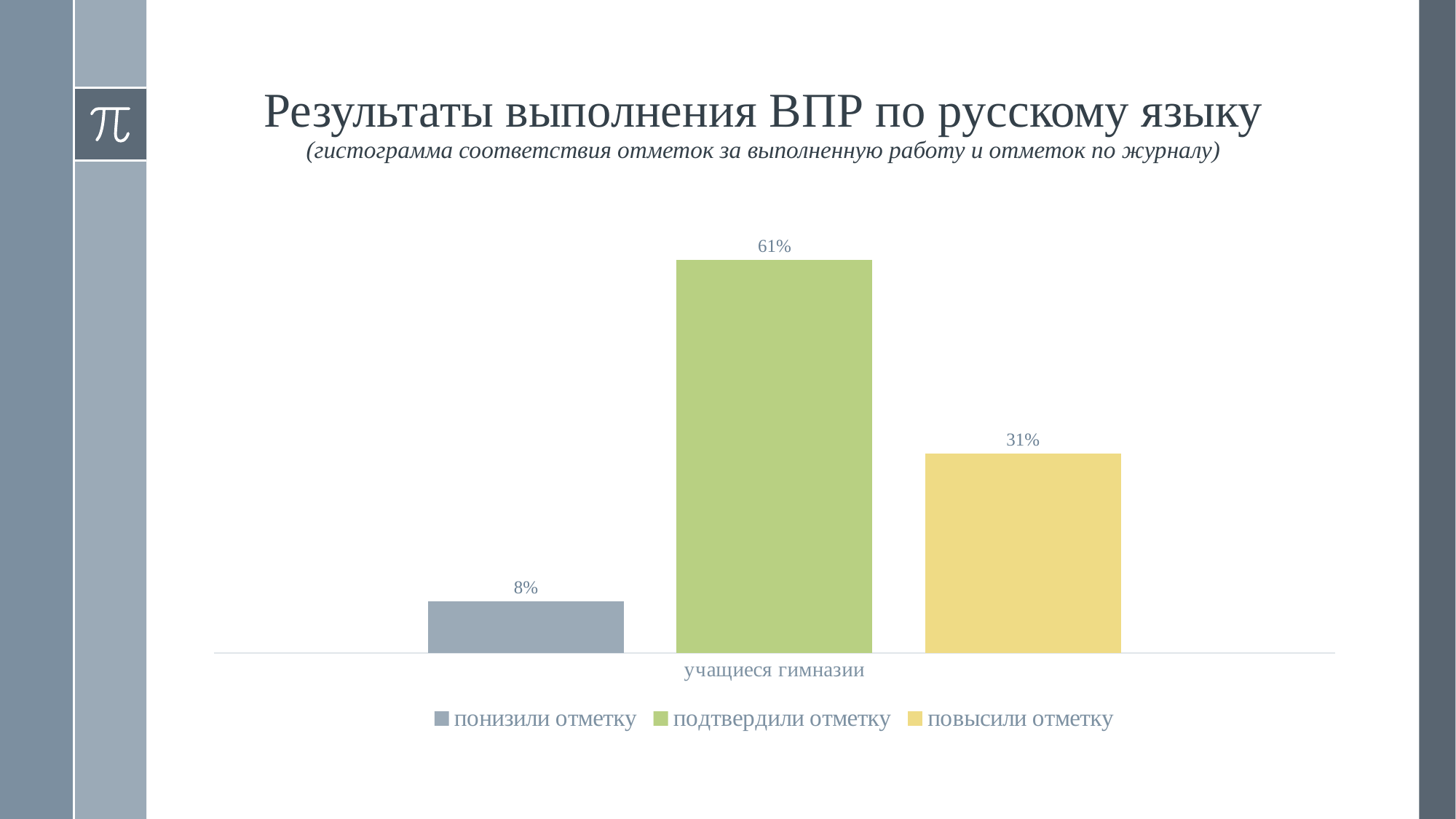
What is the difference between the values for "подтвердили отметку" and "повысили отметку"? 30% What is the difference between the values for "повысили отметку" and "понизили отметку"? 23% What kind of chart is shown on the slide? bar chart What is the value for "подтвердили отметку"? 61% How many series does the legend list? 3 What is the category label on the x axis? учащиеся гимназии Which is larger: the value for "повысили отметку" or the value for "понизили отметку"? повысили отметку Which series has the lowest value? понизили отметку What is the value for "понизили отметку"? 8% What is the value for "повысили отметку"? 31% Which series has the highest value? подтвердили отметку What colour is the bar for "подтвердили отметку"? green